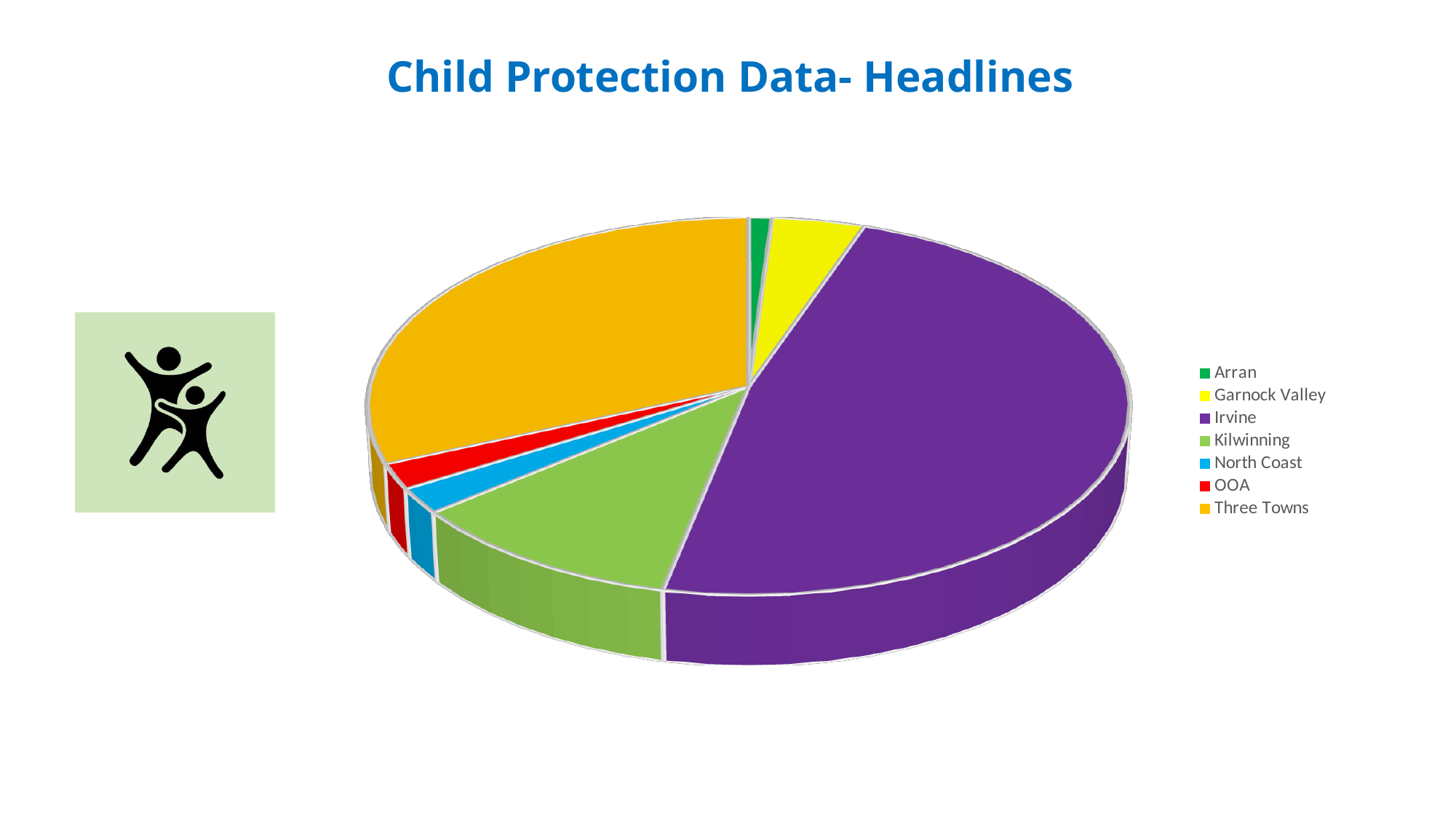
What kind of chart is shown on the slide? pie chart Which slice is larger, Kilwinning or Garnock Valley? Kilwinning What colour is the Irvine slice in the pie chart? purple How many categories does the pie chart show? 7 Which category has the smallest slice of the pie chart? Arran Which category has the largest slice of the pie chart? Irvine Which slice is larger, Garnock Valley or Arran? Garnock Valley Which category has the second-largest slice of the pie chart? Three Towns Which slice is larger, Irvine or Three Towns? Irvine What is the title of the slide? Child Protection Data- Headlines